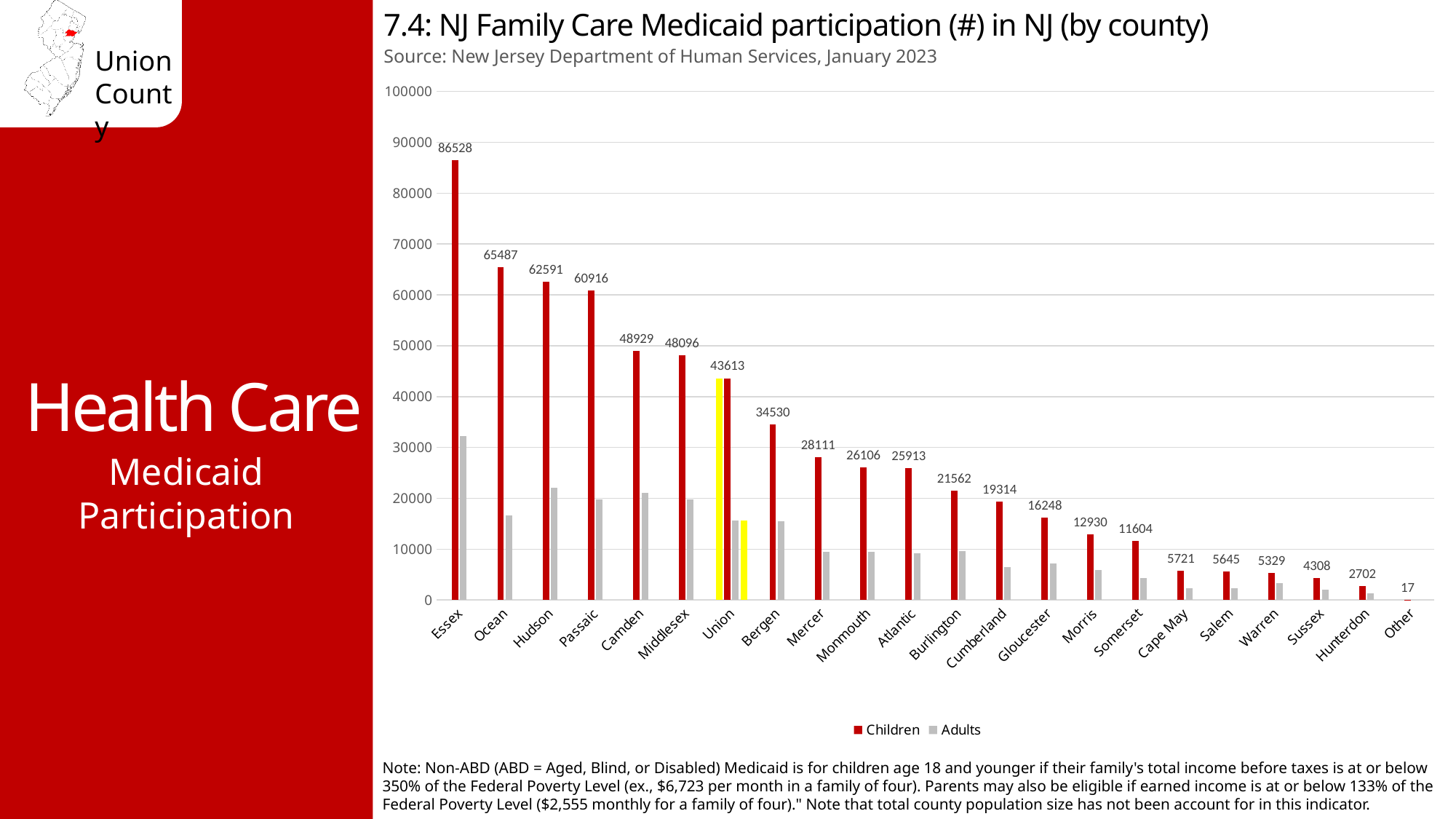
What kind of chart is shown? Bar chart Is the Adults value for Union greater or less than 20000? less What is the Children value for Union county? 43613 What is the difference between the Children values for Ocean and Hudson? 2896 Which county has the highest Children value? Essex Is the Adults value for Essex greater or less than 30000? greater Which category has the lowest Children value? Other Which has a larger Children value, Camden or Bergen? Camden How many categories are shown on the x axis? 22 Which county's bars are highlighted in yellow? Union What is the Children value for Essex county? 86528 How many series does the legend list? 2